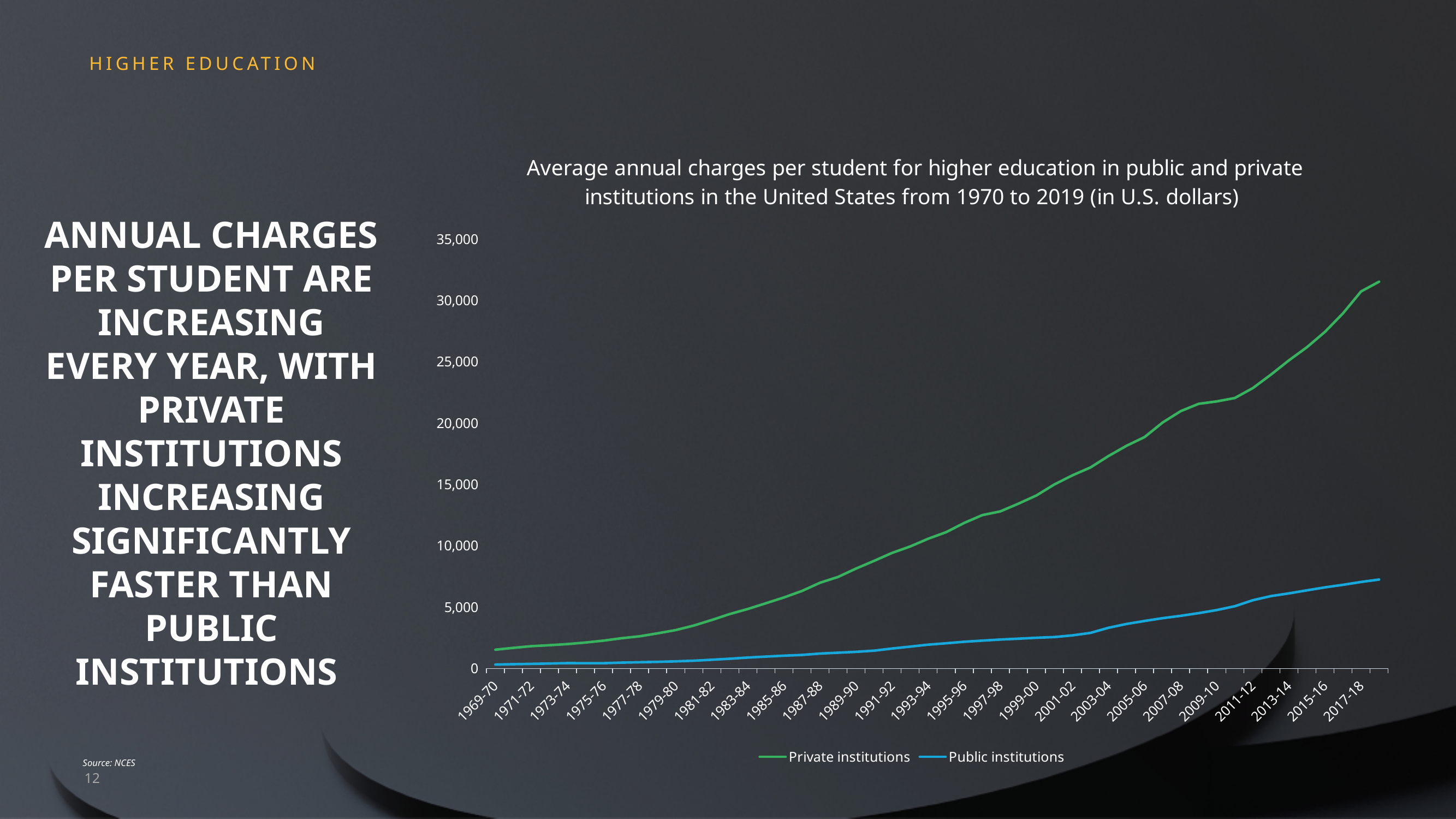
Is the value for Private institutions in 2017-18 greater or less than 25,000? greater Do the charges for Public institutions rise or fall over the period shown? Rise Do the charges for Private institutions rise or fall from 1969-70 to 2017-18? Rise What kind of chart is shown on the slide? Line chart Is the value for Private institutions in 1989-90 greater or less than 10,000? less Is the value for Public institutions in 2003-04 greater or less than 5,000? less Which series reaches the highest value on the chart? Private institutions How many series does the legend list? 2 Which two series are listed in the legend? Private institutions and Public institutions What colour is the line for Public institutions? Blue Which series has the higher value in 2017-18, Private institutions or Public institutions? Private institutions